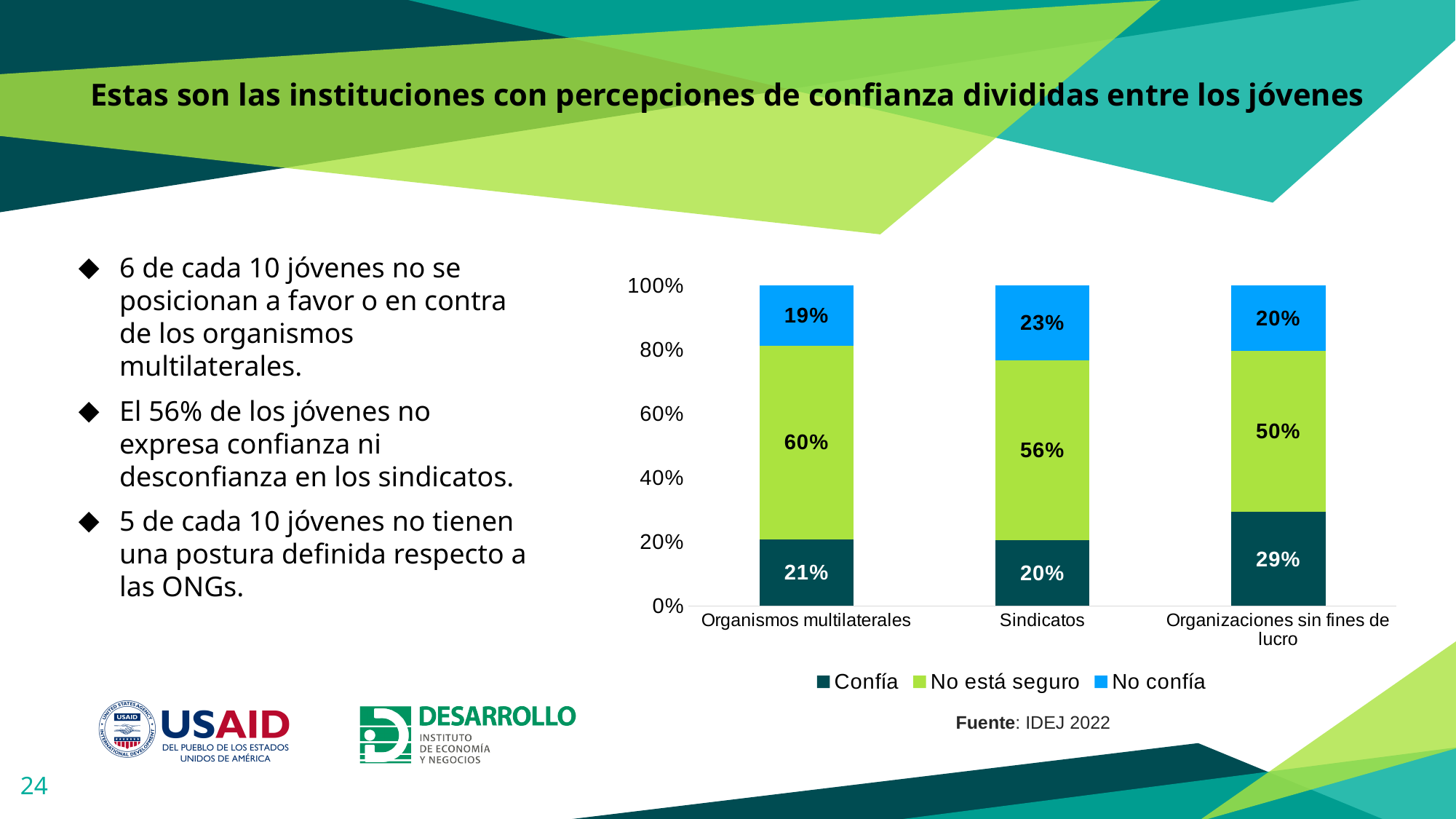
What kind of chart is shown on the slide? Stacked bar chart How many series does the legend list? 3 What is the 'Confía' value for Organizaciones sin fines de lucro? 29% What is the total of the stacked bar for Sindicatos? 99% What source is cited below the chart? IDEJ 2022 What percentage of young people say 'No está seguro' for Organismos multilaterales? 60% Which category has the highest 'Confía' value? Organizaciones sin fines de lucro What is the difference between the 'No está seguro' values for Organismos multilaterales and Sindicatos? 4% What is the 'No confía' value for Sindicatos? 23% How many categories are shown on the x axis? 3 Which category has the lowest 'No está seguro' value? Organizaciones sin fines de lucro Which is larger: the 'No confía' value for Sindicatos or for Organizaciones sin fines de lucro? Sindicatos